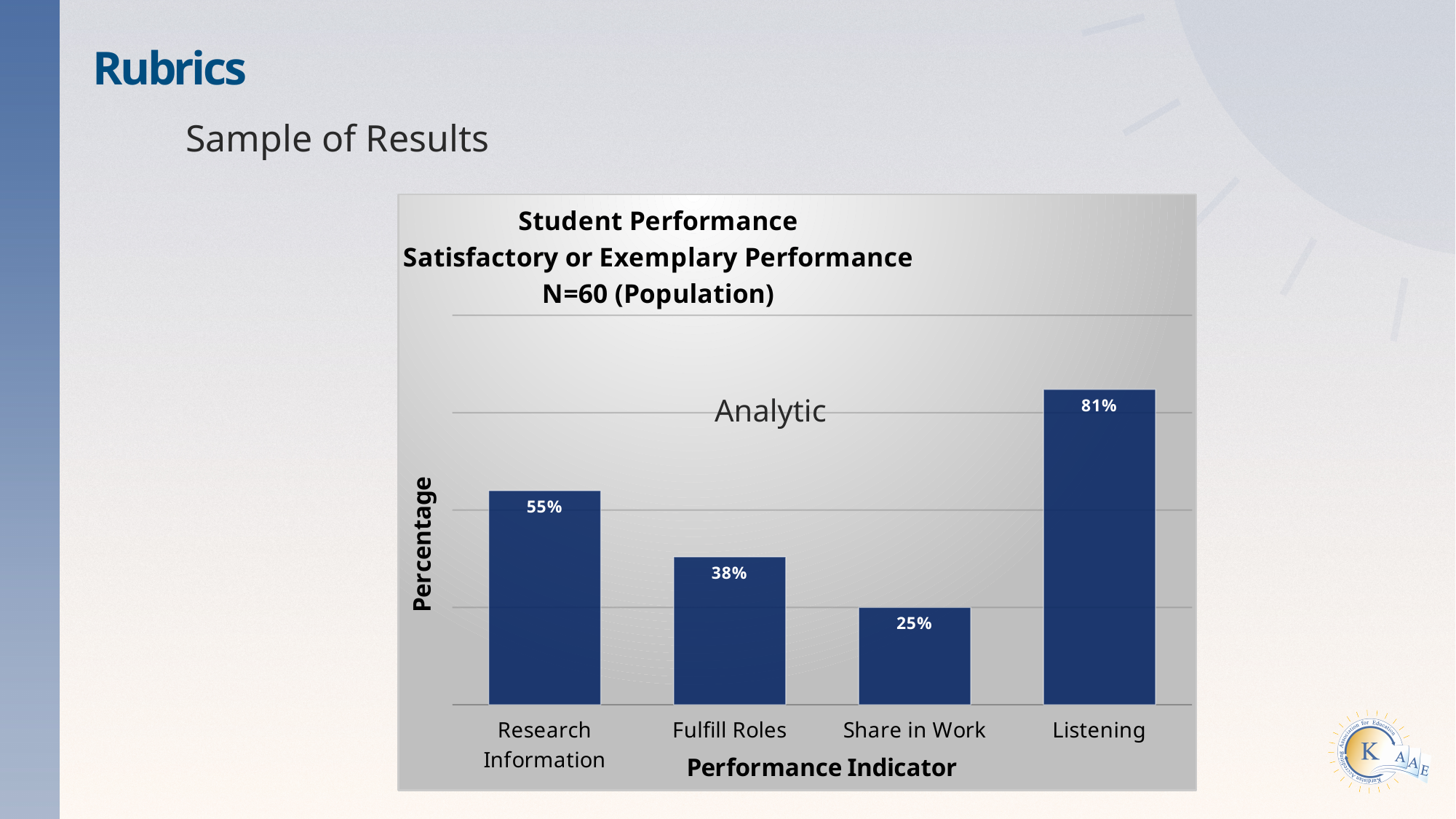
What kind of chart is shown on the slide? Bar chart What is the value for Listening? 81% Which is larger, the value for Research Information or the value for Fulfill Roles? Research Information What is the difference between the values for Listening and Research Information? 26% What is the value for Research Information? 55% What is the difference between the values for Fulfill Roles and Share in Work? 13% Which performance indicator has the lowest percentage? Share in Work Which performance indicator has the highest percentage? Listening What is the value for Fulfill Roles? 38% What is the value for Share in Work? 25% What is the label on the x axis of the chart? Performance Indicator How many performance indicators are shown on the chart? 4